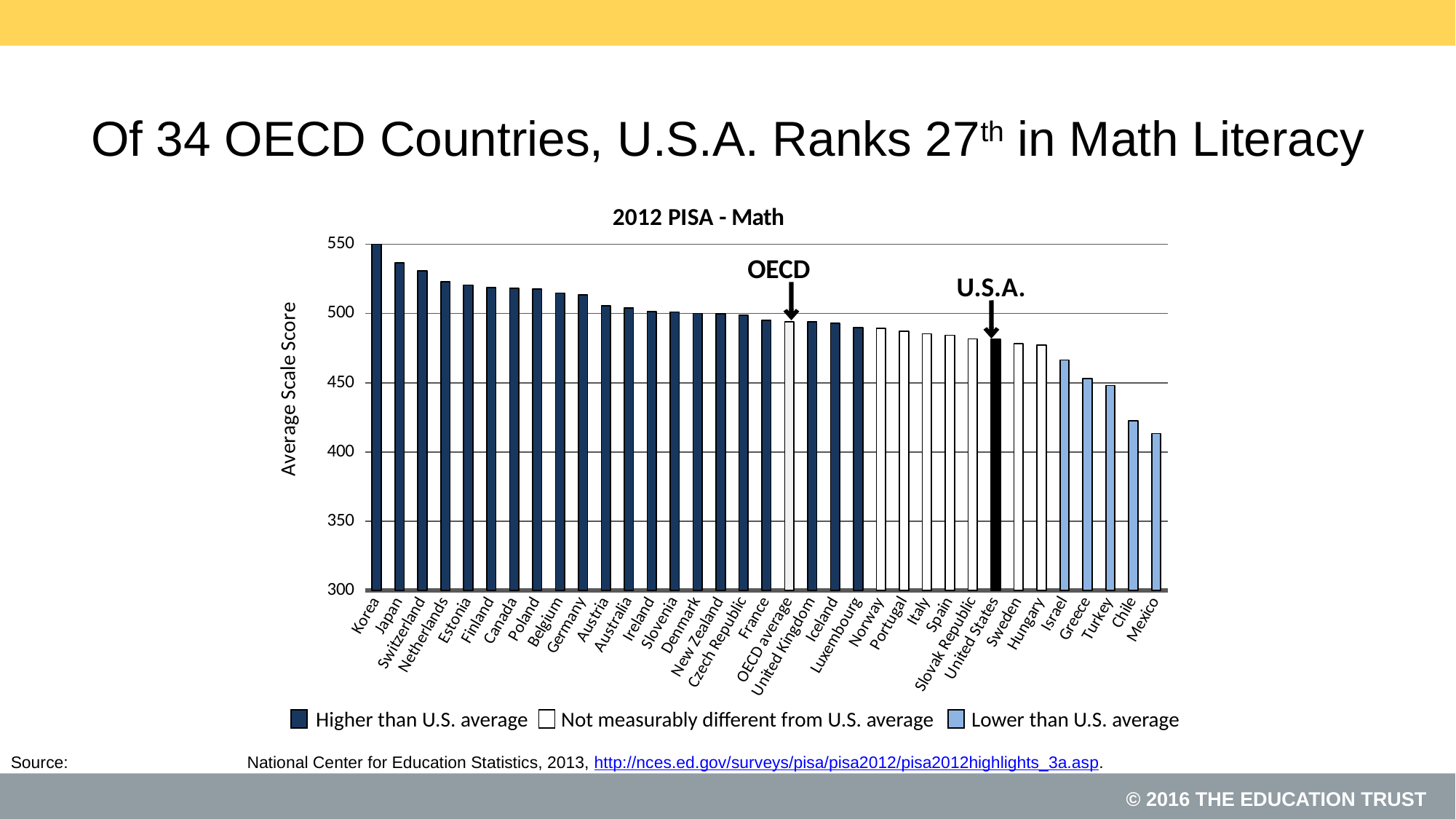
Which country has the lowest average scale score in the chart? Mexico Which has a higher average scale score, Israel or Germany? Germany Is the value for Greece greater or less than 500? less Which country has the highest average scale score in the chart? Korea Is the value for Mexico greater or less than 450? less Is the value for Korea greater or less than 500? greater What kind of chart is shown on the slide? bar chart Do the values rise or fall moving from left to right along the x axis? fall What is the title of the chart? 2012 PISA - Math Which has a higher average scale score, Japan or Chile? Japan How many entries does the legend list? 3